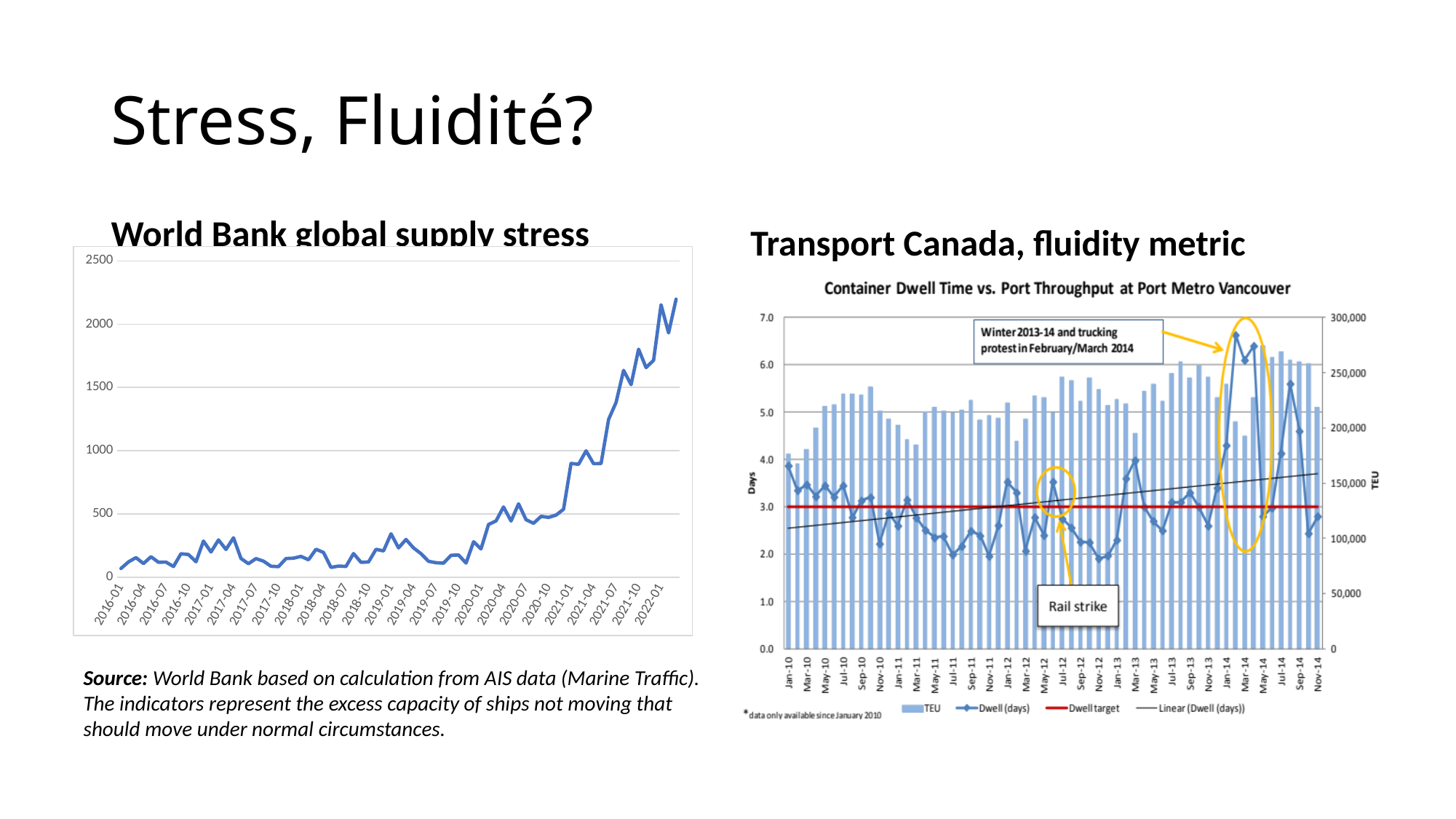
On the World Bank global supply stress chart, is the value for 2016-01 greater or less than 500? less On the World Bank global supply stress chart, is the highest value greater or less than 2000? greater What is the title of the chart on the right of the slide? Container Dwell Time vs. Port Throughput at Port Metro Vancouver What kind of chart is the World Bank global supply stress chart on the left? line chart On the Container Dwell Time vs. Port Throughput chart, is the TEU value for Jan-10 greater or less than 200,000? less On the World Bank global supply stress chart, do the values overall rise or fall from 2016-01 to 2022-01? rise On the Container Dwell Time vs. Port Throughput chart, what is the value of the Dwell target line? 3.0 On the Container Dwell Time vs. Port Throughput chart, which event is labelled by the annotation pointing at the Jun-12 dwell peak? Rail strike How many series does the legend of the Container Dwell Time vs. Port Throughput chart list? 4